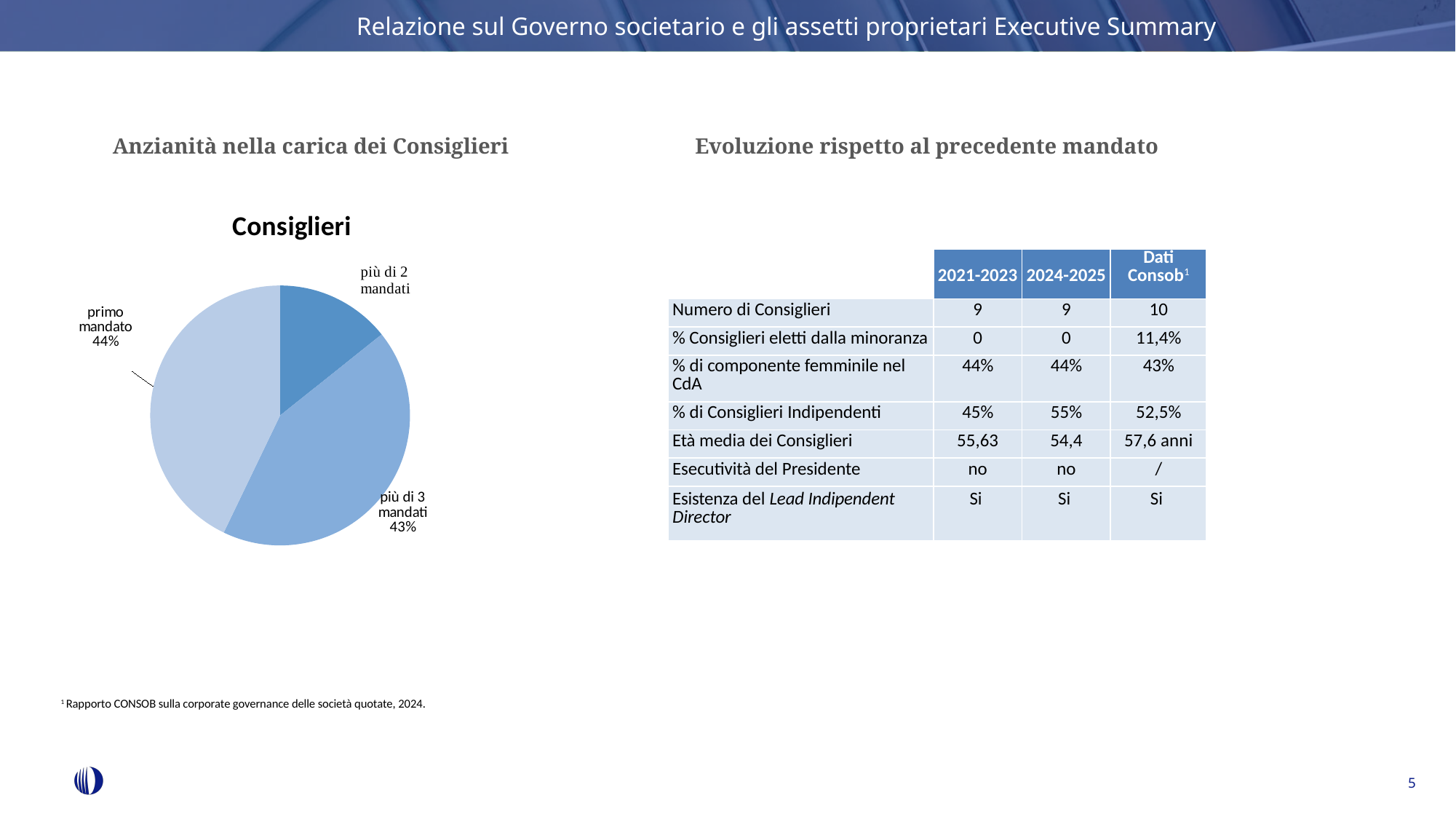
What share of the pie does "più di 3 mandati" represent? 43% What share of the pie does "primo mandato" represent? 44% Which is larger: the slice for "più di 3 mandati" or the slice for "più di 2 mandati"? più di 3 mandati Which slice of the pie chart has no percentage label printed next to it? più di 2 mandati How many slices does the pie chart have? 3 Which is larger: the slice for "primo mandato" or the slice for "più di 2 mandati"? primo mandato What kind of chart is shown on the slide? pie chart Which slice of the pie chart is the smallest? più di 2 mandati What is the title of the pie chart? Consiglieri What is the difference in percentage points between the "primo mandato" slice and the "più di 3 mandati" slice? 1